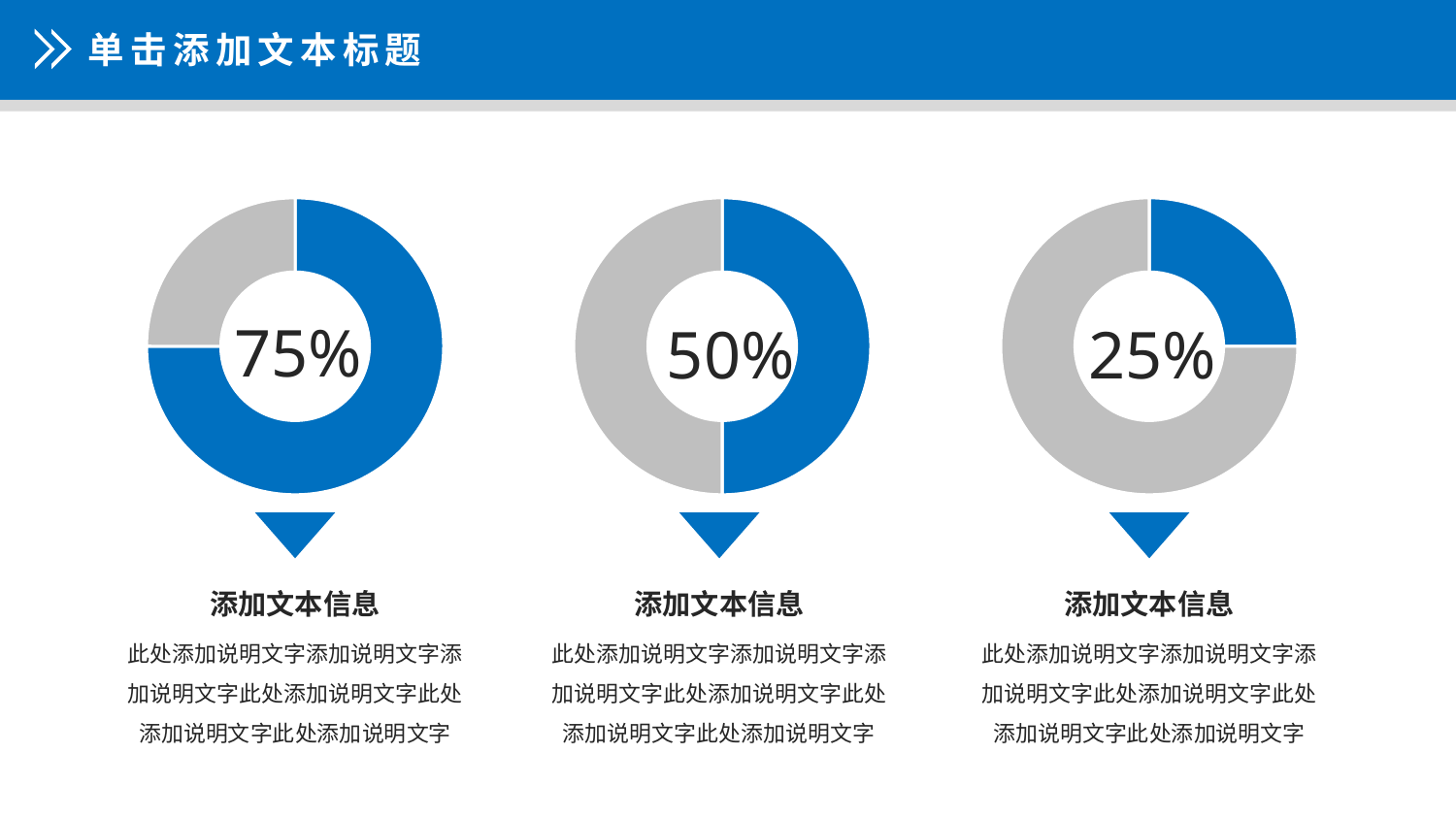
How many donut charts are on the slide? 3 What percentage is shown in the centre of the left donut chart? 75% What is the difference between the percentage in the left donut chart and the percentage in the middle donut chart? 25% Which is larger, the percentage in the middle donut chart or the percentage in the right donut chart? The middle chart (50%) What percentage is shown in the centre of the middle donut chart? 50% In the left donut chart, what share of the ring is filled in blue? 75% Which donut chart shows the highest percentage? The left chart (75%) What kind of chart is shown three times on the slide? Donut chart What colour is used for the filled portion of each donut chart? Blue What is the difference between the percentage in the left donut chart and the percentage in the right donut chart? 50% What percentage is shown in the centre of the right donut chart? 25% Which donut chart shows the lowest percentage? The right chart (25%)